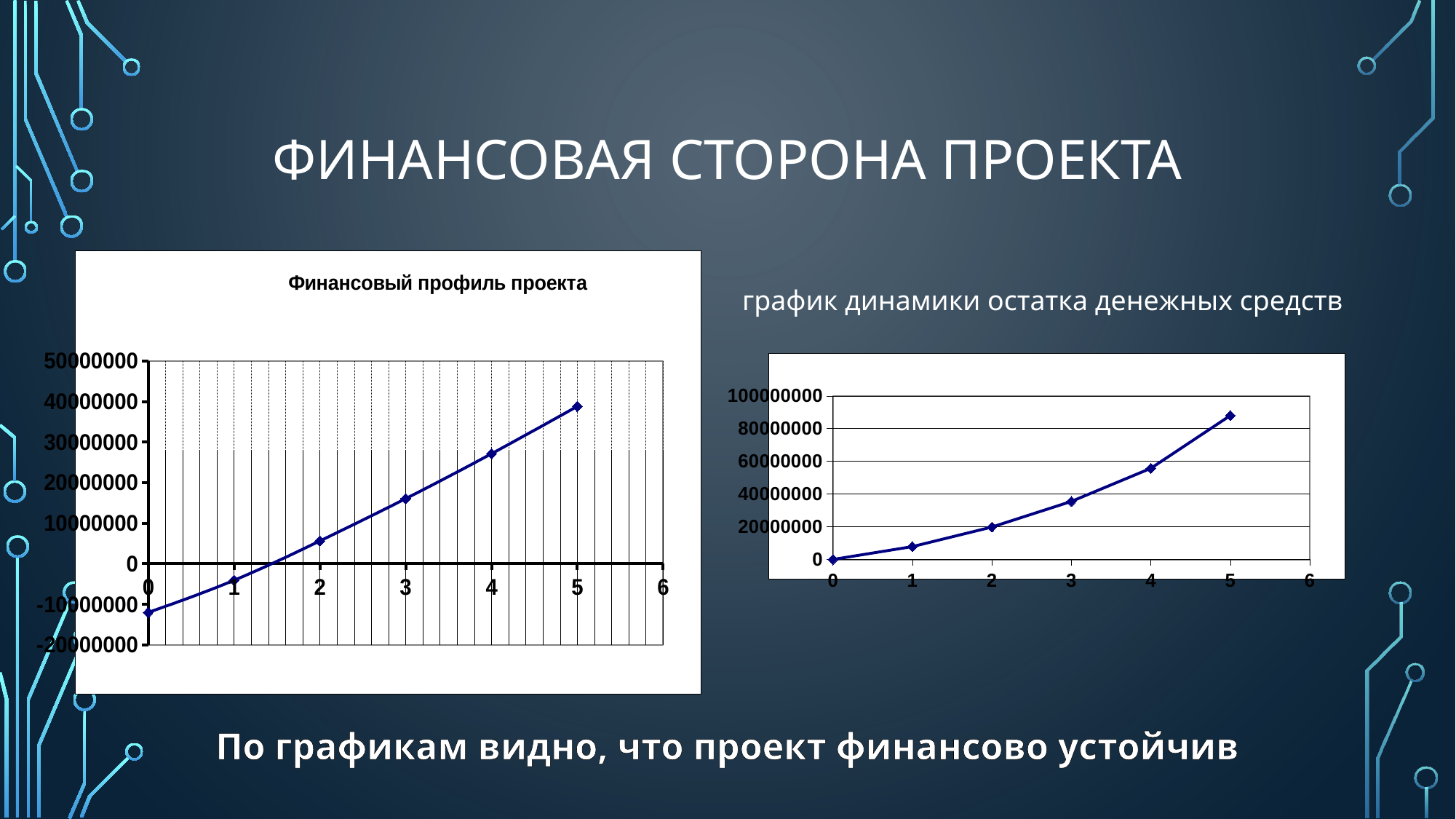
What type of chart is the left chart titled "Финансовый профиль проекта"? line chart In the right chart "график динамики остатка денежных средств", is the value at x = 3 greater or less than 40000000? less In the right chart "график динамики остатка денежных средств", is the value at x = 5 greater or less than 80000000? greater In the right chart "график динамики остатка денежных средств", at which x value is the plotted value highest? 5 In the left chart "Финансовый профиль проекта", is the value at x = 0 greater or less than 0? less In the right chart "график динамики остатка денежных средств", how many data points are plotted? 6 In the left chart "Финансовый профиль проекта", how many data points are plotted? 6 What type of chart is the right chart, "график динамики остатка денежных средств"? line chart In the left chart "Финансовый профиль проекта", do the values rise or fall as x increases from 0 to 5? rise In the left chart "Финансовый профиль проекта", at which x value is the plotted value lowest? 0 In the right chart "график динамики остатка денежных средств", do the values rise or fall along the x axis? rise